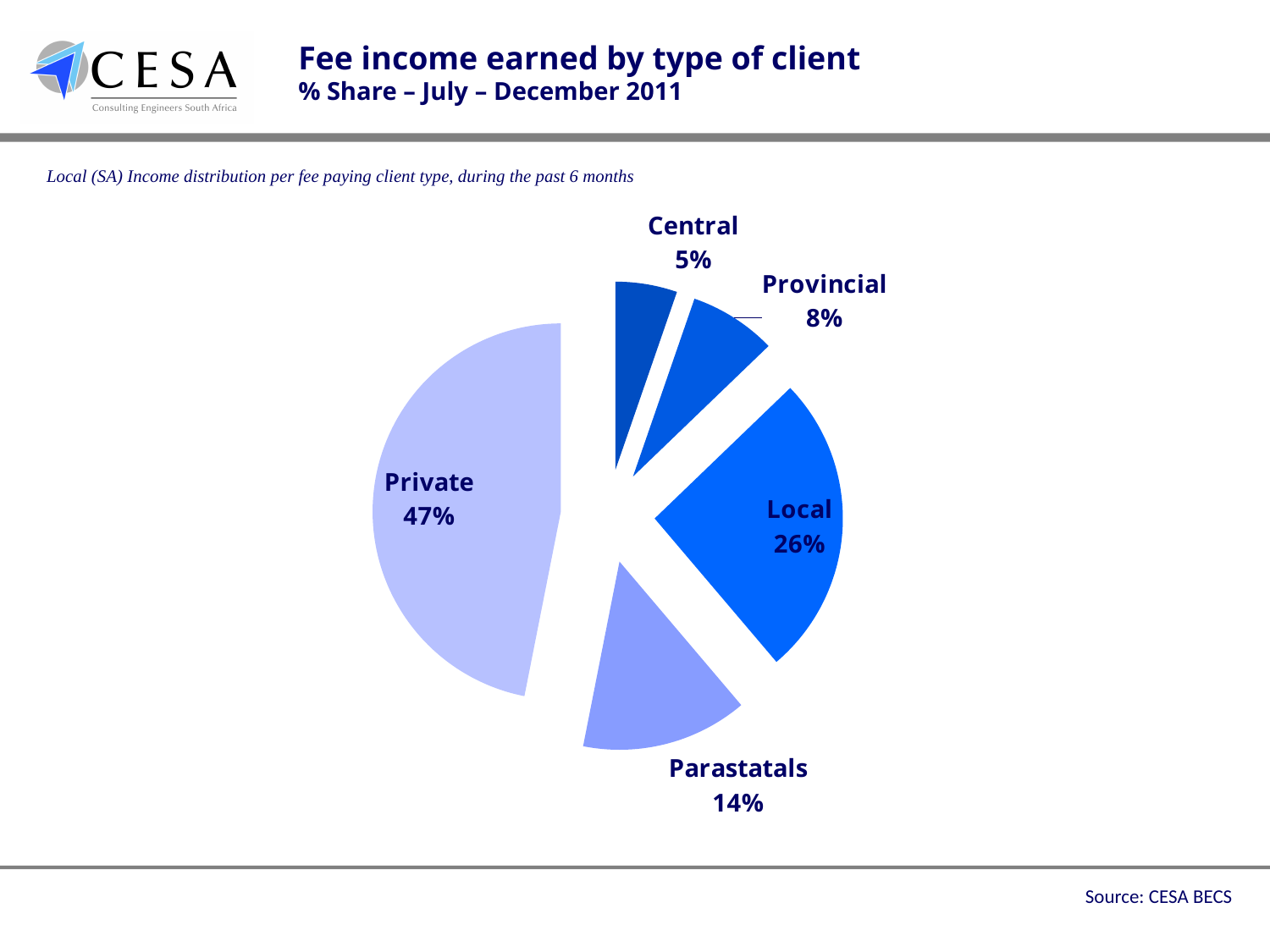
What share of fee income came from Provincial clients? 8% What share of fee income came from Central clients? 5% What is the difference in percentage points between the Private and Local shares? 21 How many client types are shown in the pie chart? 5 What share of fee income came from Parastatals? 14% What period does the chart title say the fee income shares cover? July – December 2011 Which client type has the smallest share of fee income? Central Which client type has the largest share of fee income? Private What kind of chart is shown on the slide? Pie chart What share of fee income came from Private clients? 47% Which has a larger share of fee income, Parastatals or Provincial? Parastatals What share of fee income came from Local clients? 26%